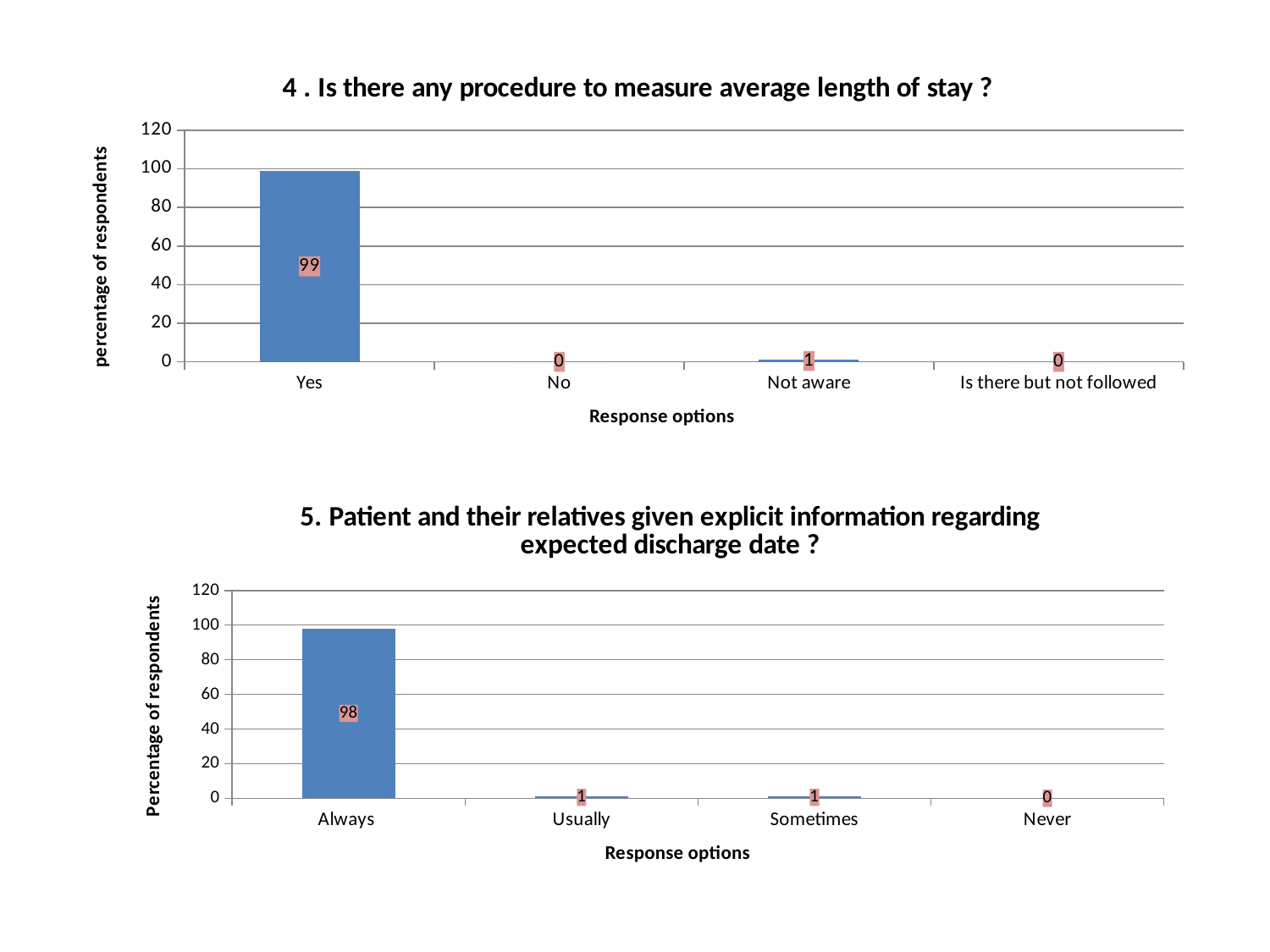
In the bottom chart (question 5, explicit information regarding expected discharge date), what is the value for "Always"? 98 In the top chart (question 4), how many response options are shown on the x axis? 4 In the top chart (question 4, procedure to measure average length of stay), what is the value for "Yes"? 99 In the bottom chart (question 5), what is the value for "Never"? 0 In the top chart (question 4), what is the value for "Not aware"? 1 In the bottom chart (question 5), what is the difference between the values for "Always" and "Usually"? 97 In the top chart (question 4), what is the difference between the values for "Yes" and "Not aware"? 98 In the bottom chart (question 5), which response option has the highest value? Always What kind of chart is the bottom chart (question 5)? Bar chart In the top chart (question 4), is the value for "Yes" greater or less than 80? greater In the top chart (question 4), which response option has the highest value? Yes What is the x-axis title of the top chart (question 4)? Response options